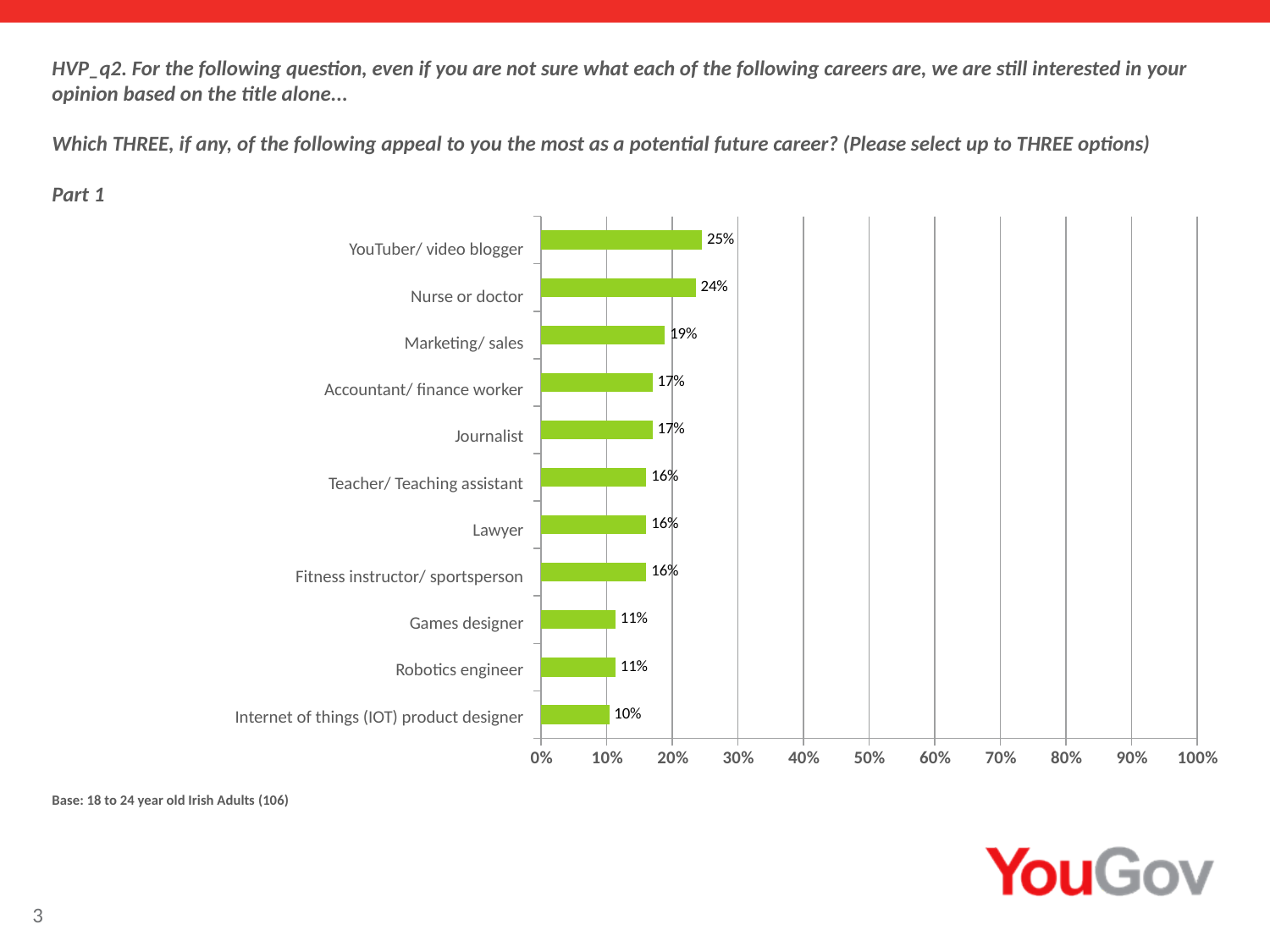
What is the value for Robotics engineer? 11% What percentage is shown for Internet of things (IOT) product designer? 10% Which career has the highest percentage? YouTuber/ video blogger What is the difference between the values for YouTuber/ video blogger and Marketing/ sales? 6% Is the value for Journalist greater or less than 20%? less What is the value for Nurse or doctor? 24% What is the difference between the values for Nurse or doctor and Games designer? 13% What percentage of respondents chose YouTuber/ video blogger? 25% Which is larger, the value for Marketing/ sales or the value for Lawyer? Marketing/ sales How many careers are listed in the chart? 11 What kind of chart is shown on the slide? Bar chart Which career has the lowest percentage? Internet of things (IOT) product designer